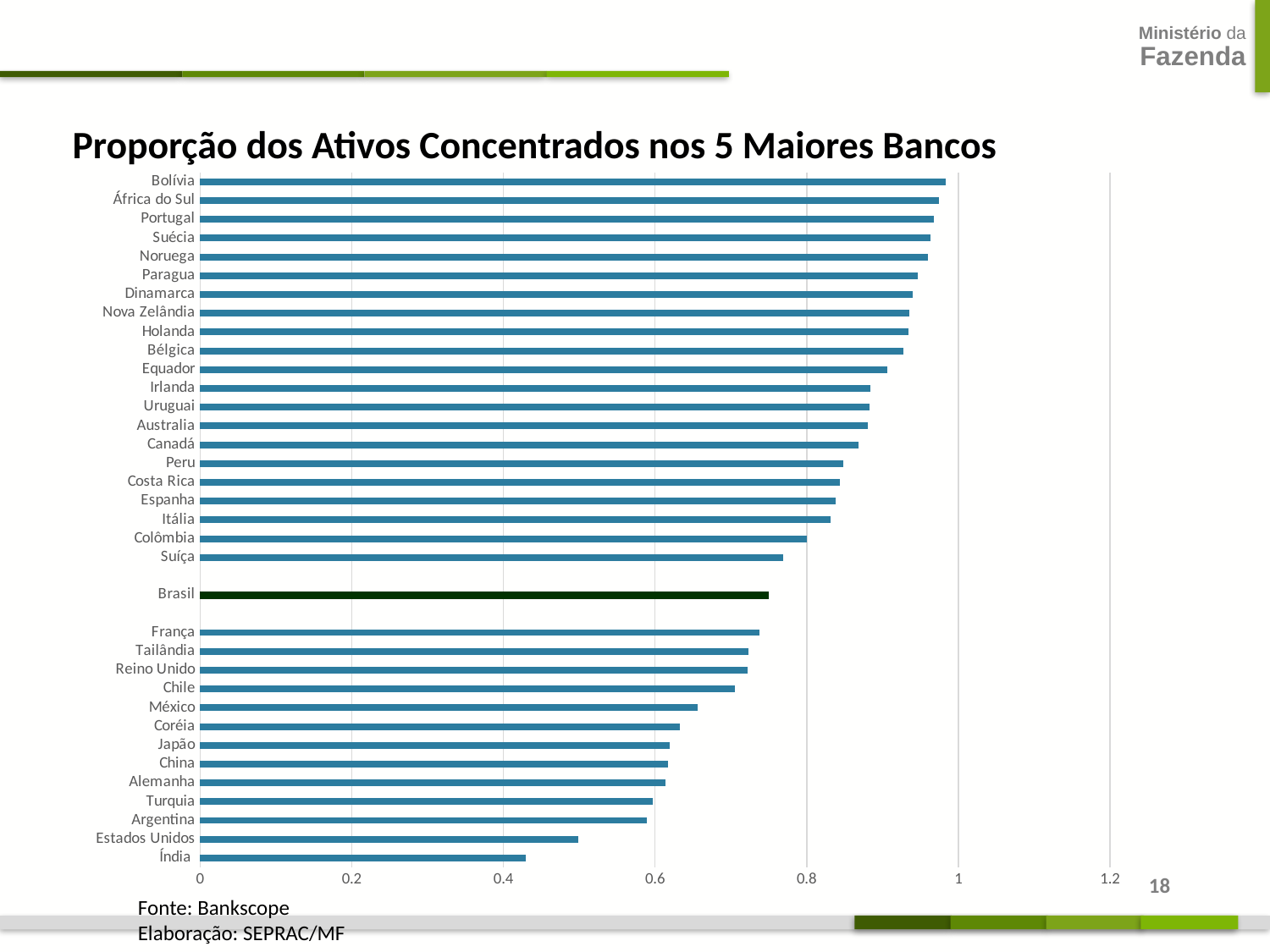
What is the title of the chart? Proporção dos Ativos Concentrados nos 5 Maiores Bancos Which country's bar is drawn in a different colour (dark green) from the others? Brasil Is the value for Brasil greater or less than 0.6? greater Which country has the lowest value in the chart? Índia Is the value for Brasil greater or less than 0.8? less Is the value for Estados Unidos greater or less than 0.6? less Which country has the highest value in the chart? Bolívia Which has a larger value, Brasil or Estados Unidos? Brasil What kind of chart is shown on the slide? bar chart Which has a larger value, Índia or Portugal? Portugal How many countries are listed in the chart? 35